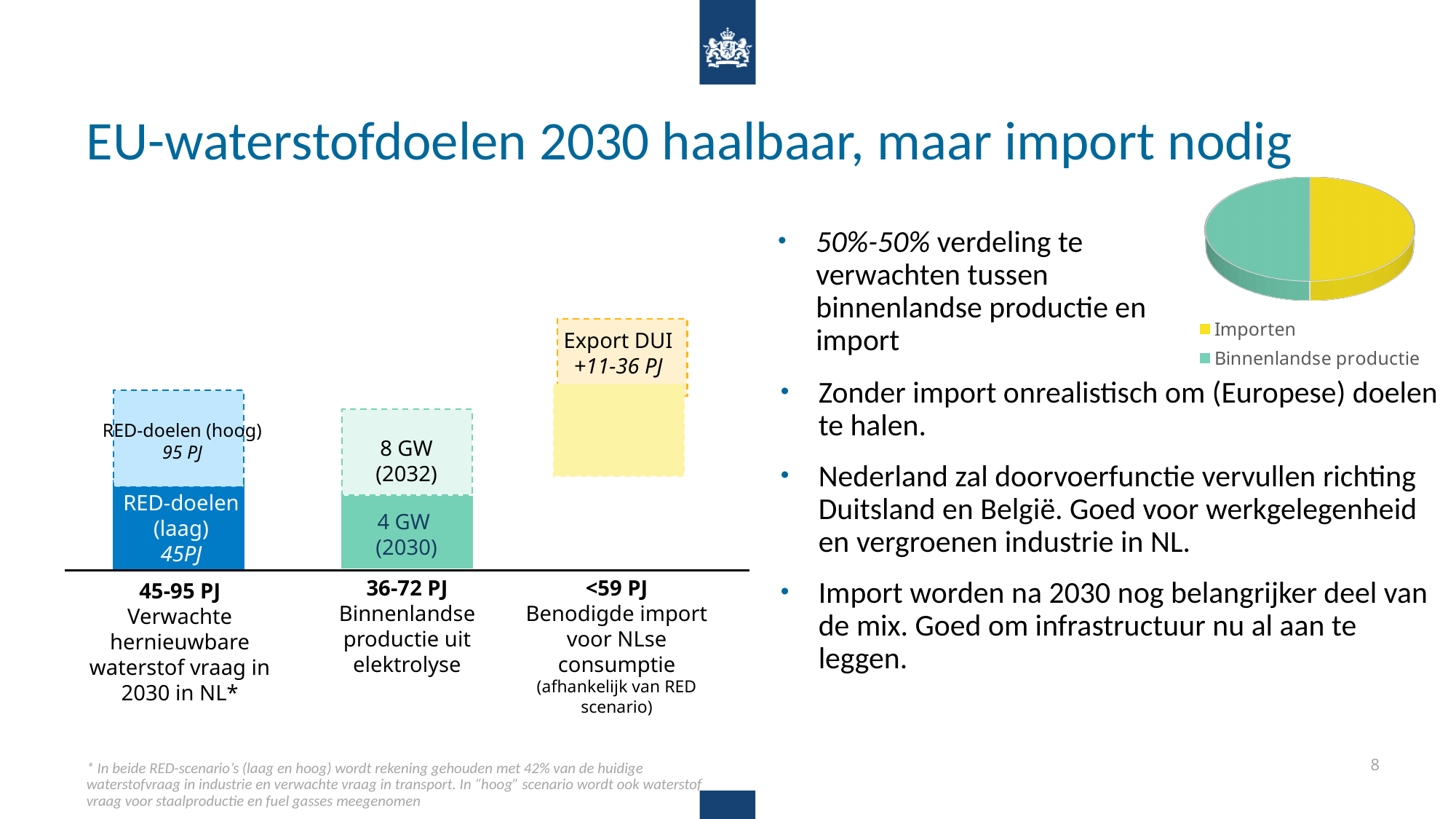
In the bar diagram on the left, what range is printed under the bar for Binnenlandse productie uit elektrolyse? 36-72 PJ In the pie chart at the top right, what share of the pie does the Importen slice take? 50% In the bar diagram on the left, what value is printed under the bar for Benodigde import voor NLse consumptie? <59 PJ In the pie chart at the top right, how many entries does the legend list? 2 In the pie chart at the top right, which colour represents Importen? yellow In the bar diagram on the left, what value is printed in the Export DUI box? +11-36 PJ In the bar diagram on the left, how many bars are shown along the baseline? 3 What kind of chart is shown in the top right of the slide, next to the bullet points? pie chart In the pie chart at the top right, which legend entry is shown in green? Binnenlandse productie In the pie chart at the top right, what share of the pie does the Binnenlandse productie slice take? 50% In the bar diagram on the left, what value is printed for RED-doelen (hoog)? 95 PJ In the bar diagram on the left, what value is printed for RED-doelen (laag)? 45PJ